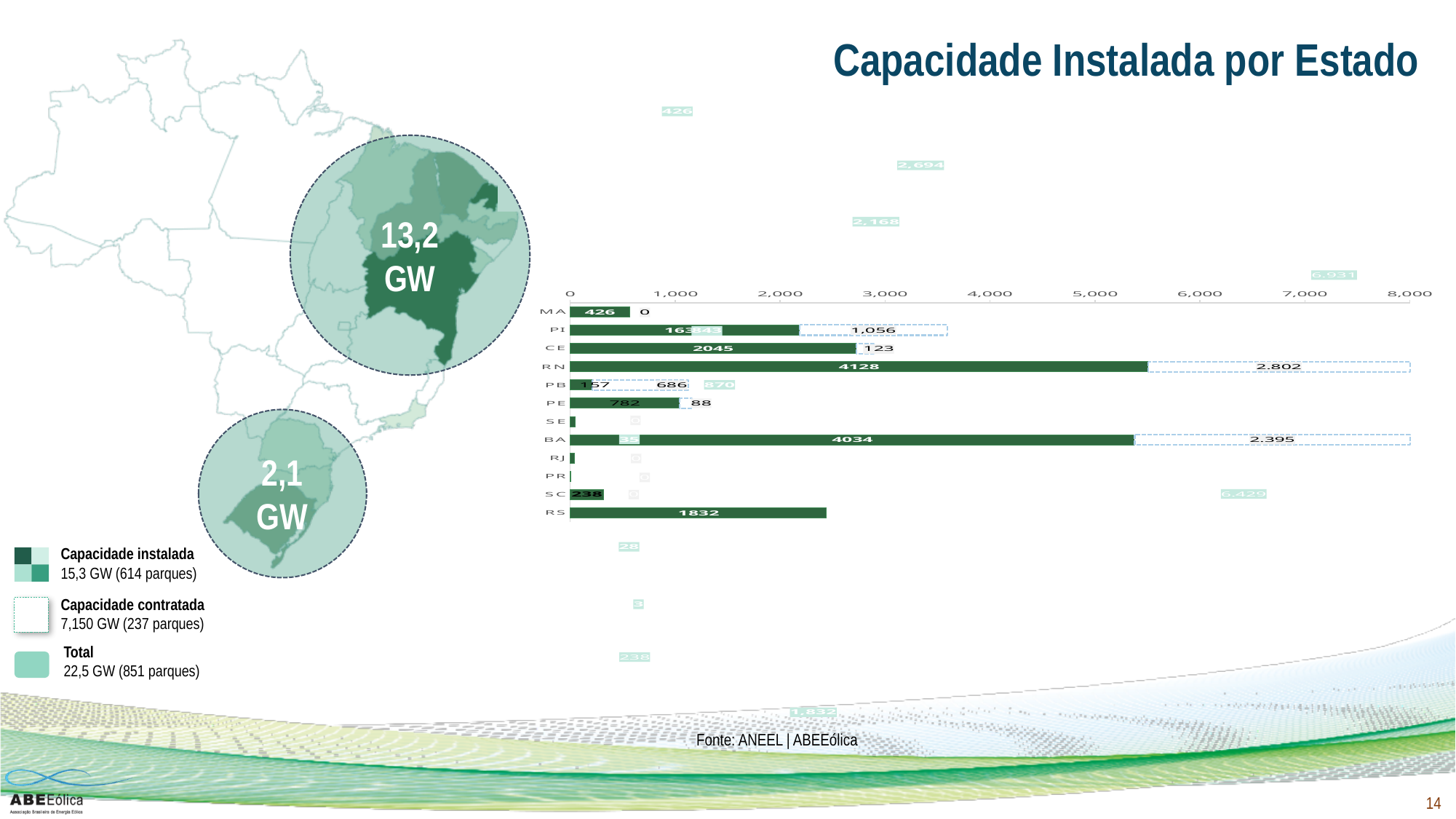
What is the installed capacity (dark green bar) value for RS? 1832 Which state has the highest installed capacity (dark green bar)? RN What kind of chart is shown on the slide? bar chart Which is larger, the installed capacity of RN or of BA? RN What is the difference between the installed capacity of CE (2045) and RS (1832)? 213 What is the installed capacity (dark green bar) value for RN? 4128 What is the title of the slide's chart? Capacidade Instalada por Estado What is the contracted capacity (dashed bar) value for BA? 2.395 What is the contracted capacity (dashed bar) value for RN? 2.802 How many states are listed on the chart's vertical axis? 12 What is the installed capacity (dark green bar) value for CE? 2045 Is the installed capacity value for RS greater or less than 2,000? less